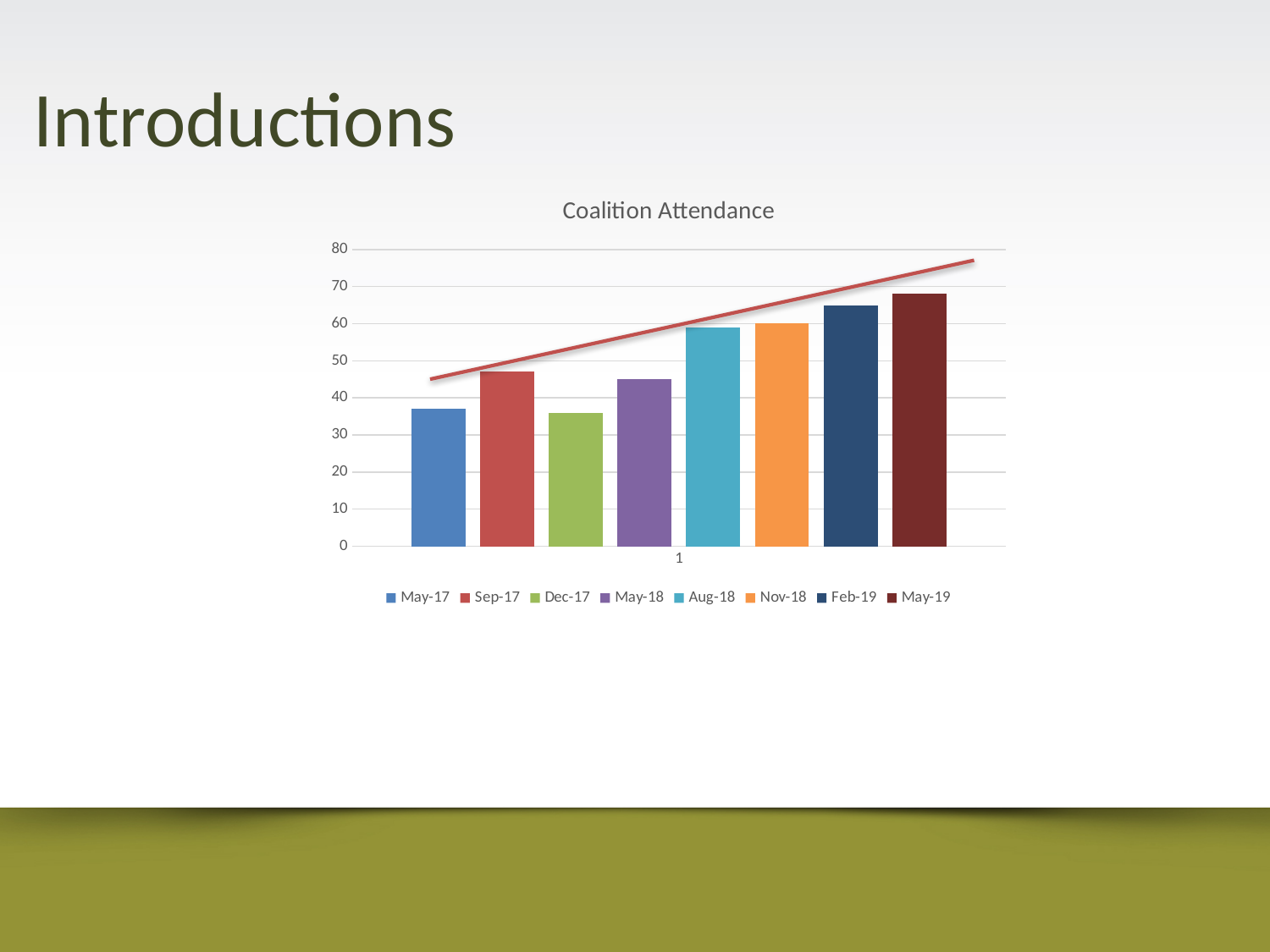
How many series does the legend list? 8 Which is larger, the value for Feb-19 or the value for May-18? Feb-19 Which is larger, the value for Sep-17 or the value for Dec-17? Sep-17 Is the value for May-19 greater or less than 70? less Is the value for Dec-17 greater or less than 40? less Do the bars generally rise or fall from May-17 to May-19? rise Is the value for Feb-19 greater or less than 60? greater Which series has the highest bar? May-19 What is the title of the chart? Coalition Attendance What kind of chart is shown on the slide? bar chart